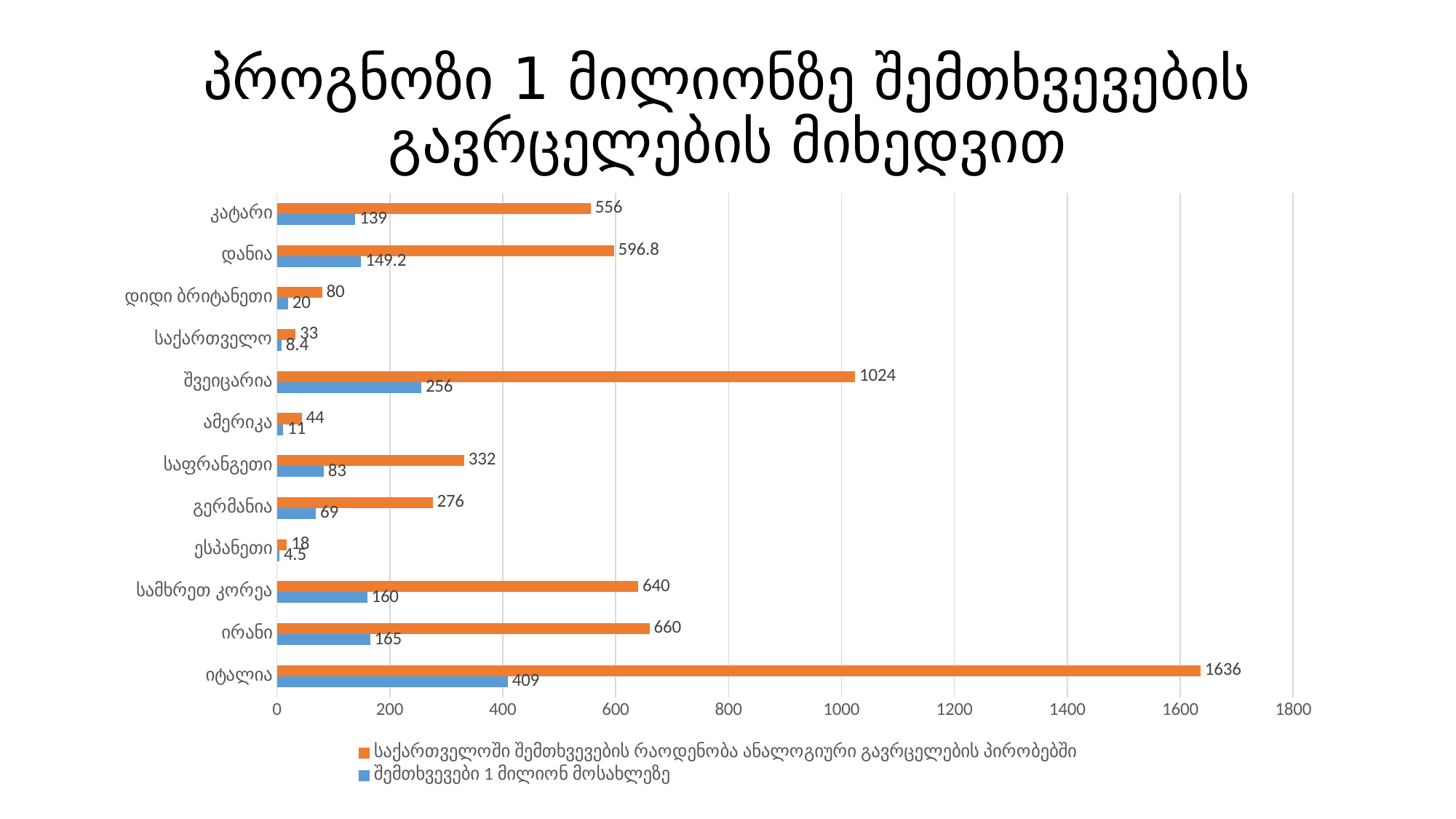
What is the difference between the orange-series values for ირანი and სამხრეთ კორეა? 20 Is the orange-series value for იტალია greater or less than 1600? greater What colour represents the series შემთხვევები 1 მილიონ მოსახლეზე? blue What is the value of the orange series (საქართველოში შემთხვევების რაოდენობა ანალოგიური გავრცელების პირობებში) for შვეიცარია? 1024 Which has a larger orange-series value, დანია or კატარი? დანია What kind of chart is shown on the slide? bar chart How many series does the legend list? 2 Which category has the lowest value in the blue series? ესპანეთი How many categories (countries) are shown on the chart? 12 Which category has the highest value in the orange series? იტალია What is the value of the blue series (შემთხვევები 1 მილიონ მოსახლეზე) for საქართველო? 8.4 What is the value of the blue series (შემთხვევები 1 მილიონ მოსახლეზე) for დანია? 149.2